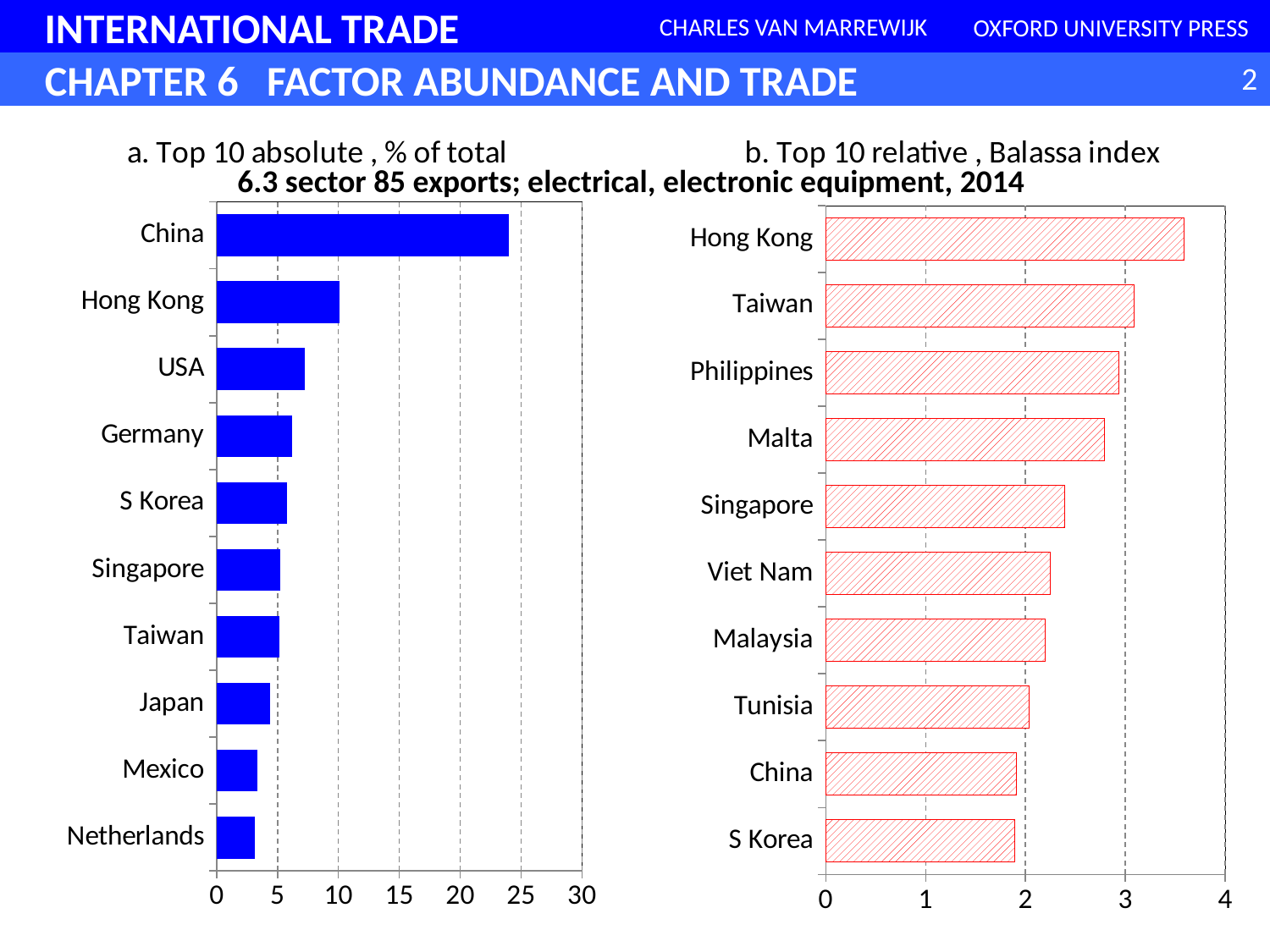
In chart b (Top 10 relative, Balassa index), which is larger, the value for Malta or the value for Tunisia? Malta In chart b (Top 10 relative, Balassa index), is the value for Hong Kong greater or less than 3? greater In chart b (Top 10 relative, Balassa index), which country has the highest value? Hong Kong In chart a (Top 10 absolute, % of total), which country has the lowest value? Netherlands What kind of chart is chart a (Top 10 absolute, % of total)? bar chart In chart a (Top 10 absolute, % of total), is the value for USA greater or less than 10? less What is the overall title shown above the two charts? 6.3 sector 85 exports; electrical, electronic equipment, 2014 In chart a (Top 10 absolute, % of total), is the value for China greater or less than 20? greater In chart a (Top 10 absolute, % of total), which country has the highest value? China In chart a (Top 10 absolute, % of total), which is larger, the value for Hong Kong or the value for Germany? Hong Kong In chart a (Top 10 absolute, % of total), how many countries are shown? 10 In chart b (Top 10 relative, Balassa index), how many countries are shown? 10